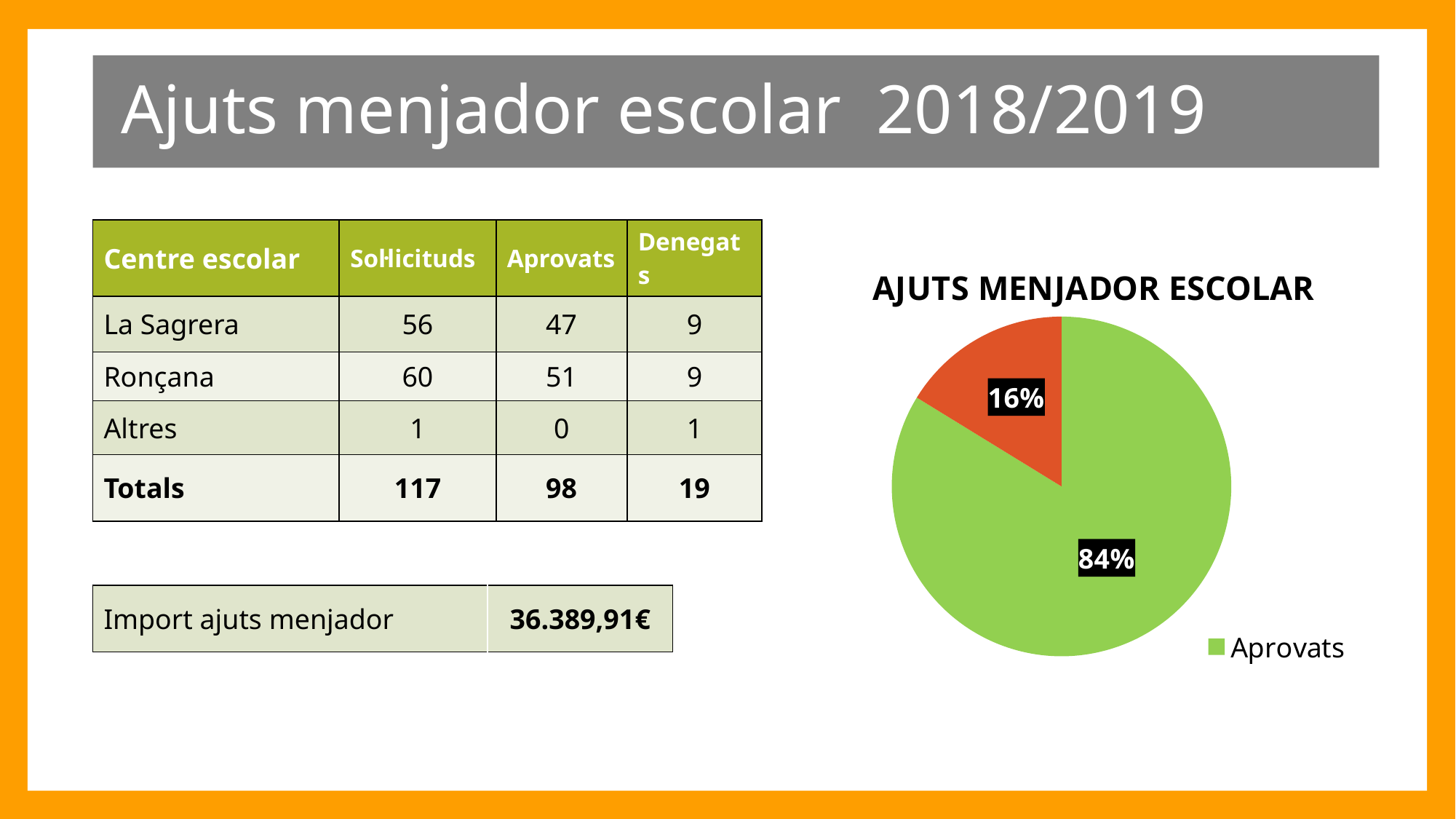
Is the Aprovats share greater or less than 50%? greater What is the difference in percentage points between the green slice and the red slice? 68 Which legend entry is shown for the pie chart? Aprovats What percentage is shown on the red slice of the pie chart? 16% Which slice is the largest in the pie chart? Aprovats What type of chart is shown on the slide? pie chart How many slices does the pie chart have? 2 Is the green slice or the red slice larger in the pie chart? green slice What is the title of the pie chart? AJUTS MENJADOR ESCOLAR What share of the pie does the Aprovats slice represent? 84% What percentage is shown on the green slice of the pie chart? 84% How many entries does the pie chart's legend list? 1